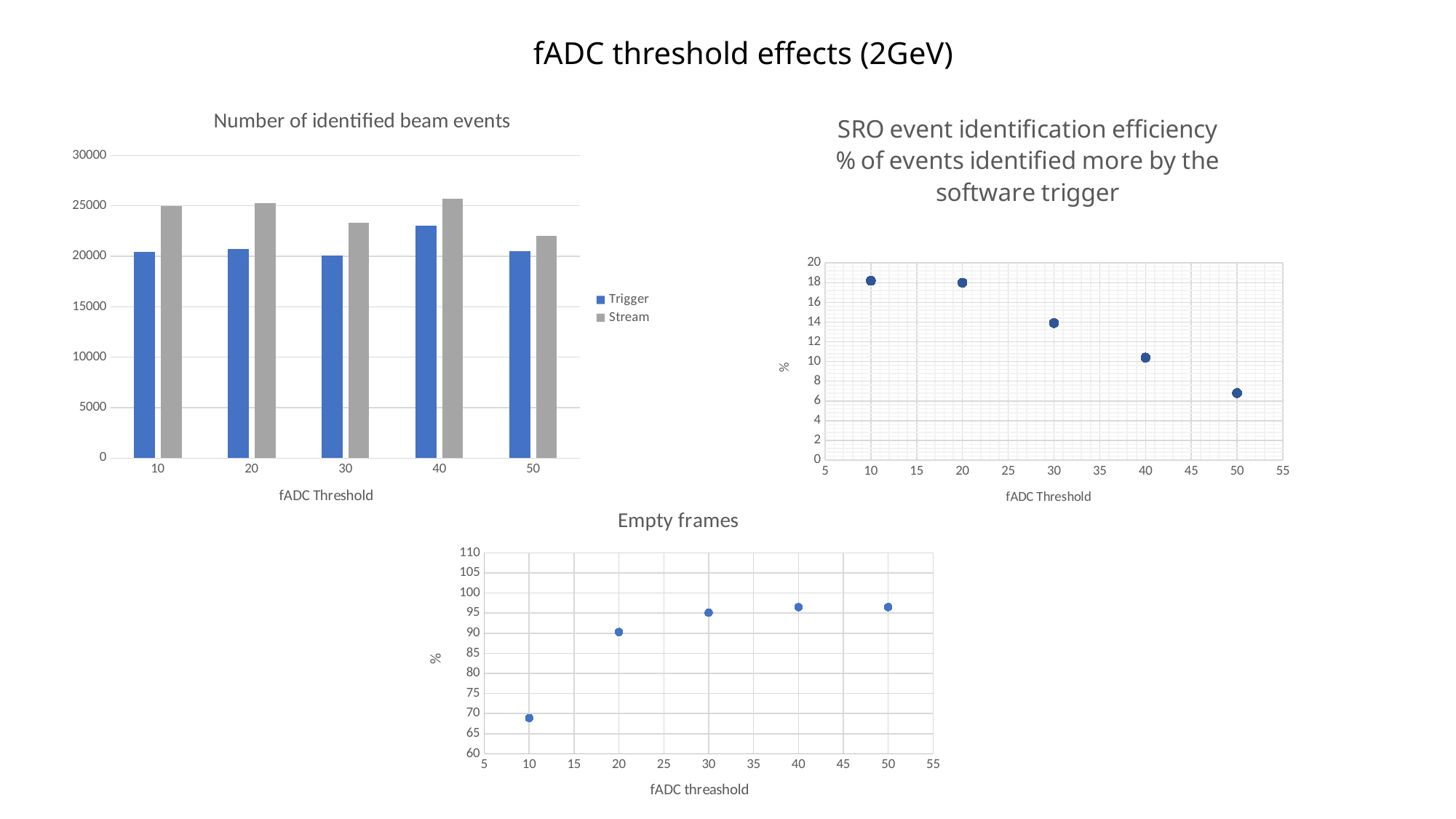
In the 'SRO event identification efficiency' chart, do the values rise or fall as fADC Threshold increases? fall In the 'SRO event identification efficiency' chart, how many data points are plotted? 5 In the 'Number of identified beam events' chart, what kind of chart is it? bar chart In the 'Number of identified beam events' chart, how many series does the legend list? 2 In the 'Empty frames' chart, at which fADC threshold is the value lowest? 10 In the 'SRO event identification efficiency' chart, is the value at fADC Threshold 50 greater or less than 8? less In the 'Number of identified beam events' chart, at which fADC Threshold is the Stream value lowest? 50 In the 'Number of identified beam events' chart, is the Trigger value at fADC Threshold 40 greater or less than 20000? greater In the 'Number of identified beam events' chart, at which fADC Threshold is the Trigger value highest? 40 In the 'Number of identified beam events' chart, at fADC Threshold 10, which is larger, Trigger or Stream? Stream In the 'Number of identified beam events' chart, is the Stream value at fADC Threshold 30 greater or less than 25000? less